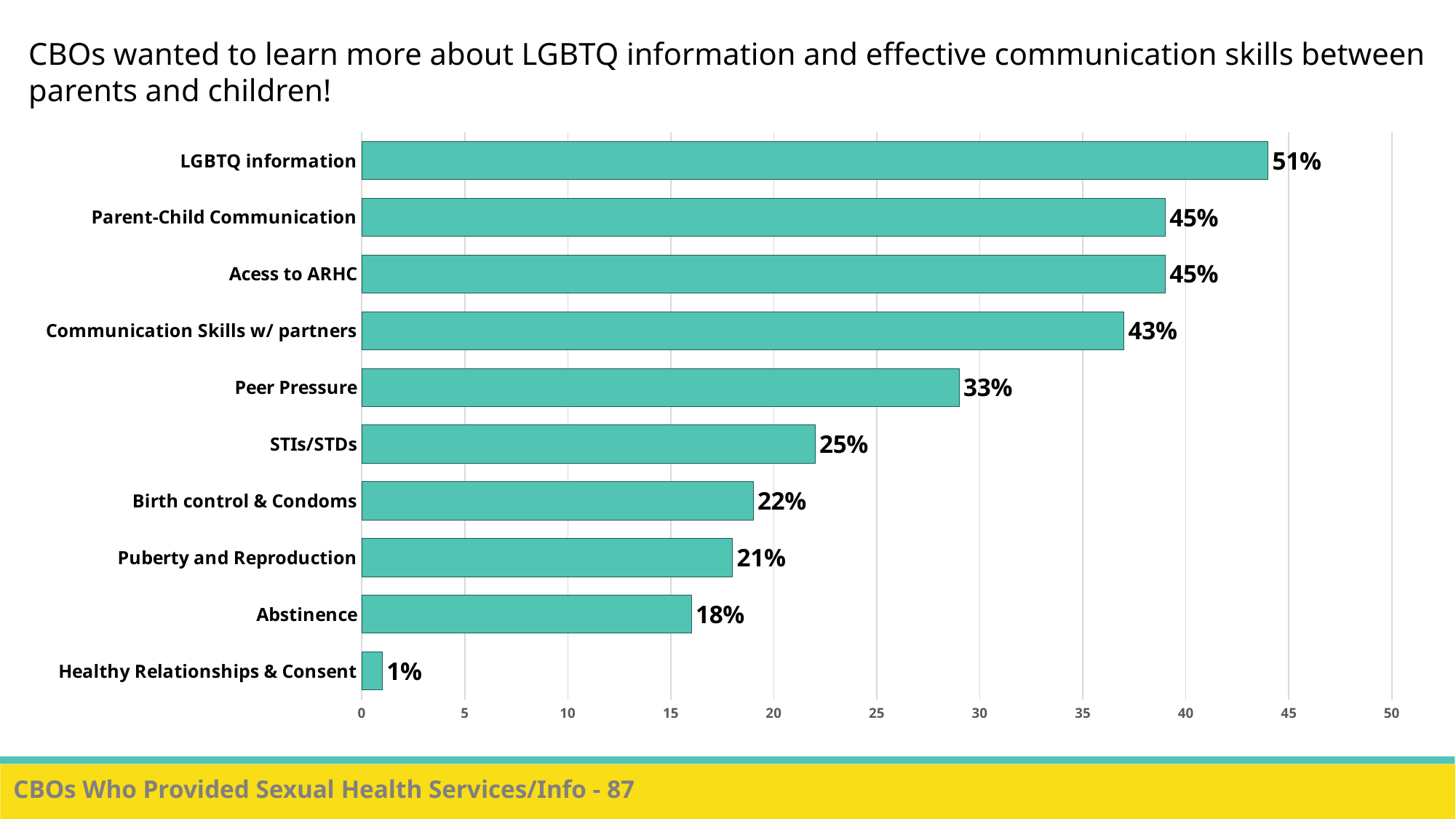
What is the value shown for LGBTQ information? 51% Do the values rise or fall going from the top category to the bottom category? Fall What is the value shown for Peer Pressure? 33% Is the bar for LGBTQ information greater or less than 40 on the axis? greater How many categories are shown in the chart? 10 Which category has the lowest value? Healthy Relationships & Consent What is the value shown for Abstinence? 18% What is the value shown for Healthy Relationships & Consent? 1% What is the difference between the values for LGBTQ information and Parent-Child Communication? 6% What kind of chart is shown on the slide? Bar chart Which has a larger value, STIs/STDs or Birth control & Condoms? STIs/STDs Which category has the highest value? LGBTQ information